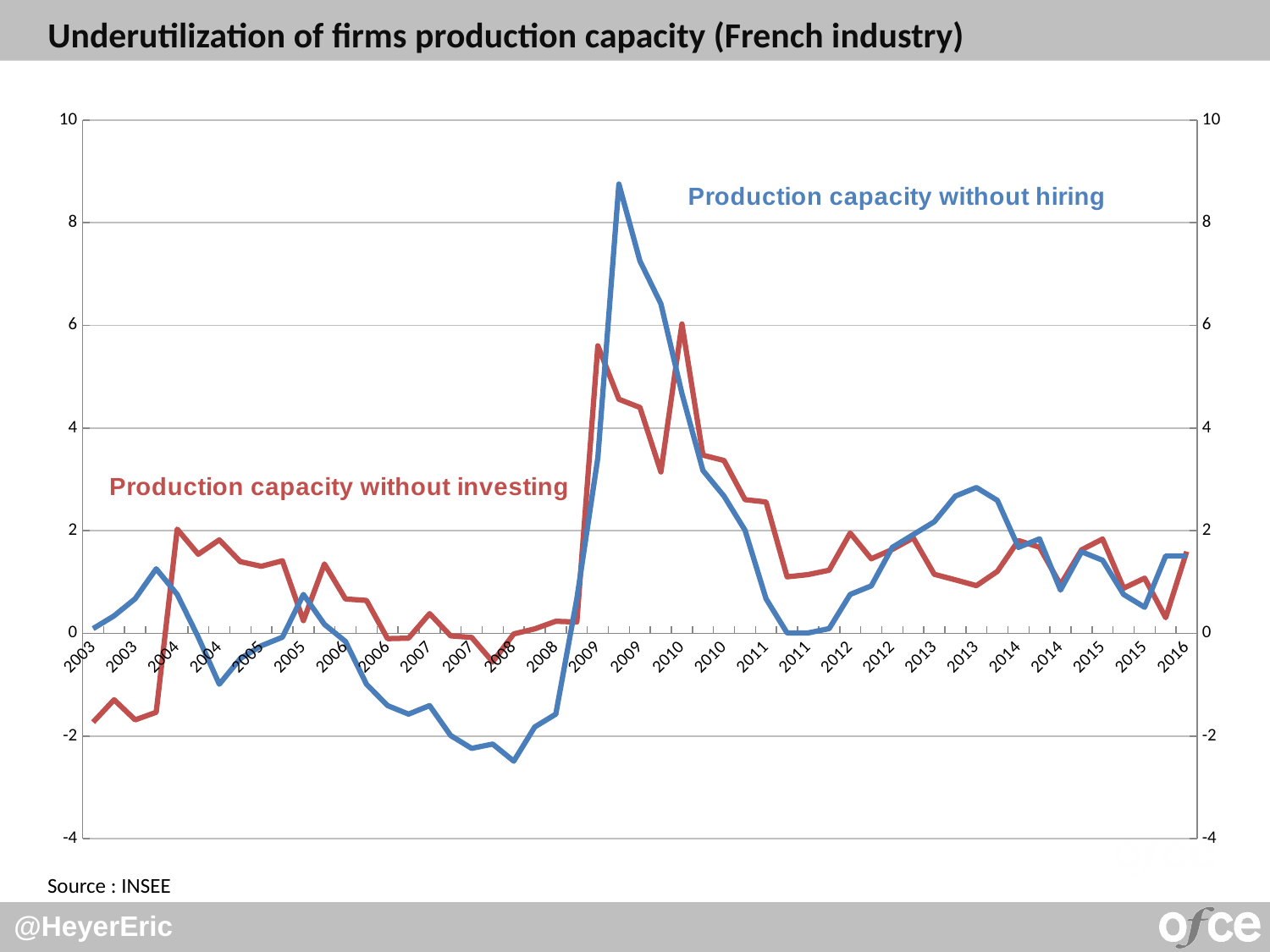
What kind of chart is shown on the slide? line chart Is the lowest value of 'Production capacity without hiring' in 2008 greater or less than -2? less How many series are plotted on the chart? 2 Which series reaches the higher peak around 2009? Production capacity without hiring What is the title of the chart? Underutilization of firms production capacity (French industry) Is the peak of 'Production capacity without hiring' in 2013 greater or less than 2? greater Does 'Production capacity without hiring' rise or fall between its 2009 peak and 2011? fall What colour is the line for 'Production capacity without hiring'? blue Which series has the lower value in 2008, just before the sharp rise? Production capacity without hiring Is the peak value of 'Production capacity without hiring' in 2009 greater or less than 8? greater Which series has the higher value at the start of 2003? Production capacity without hiring